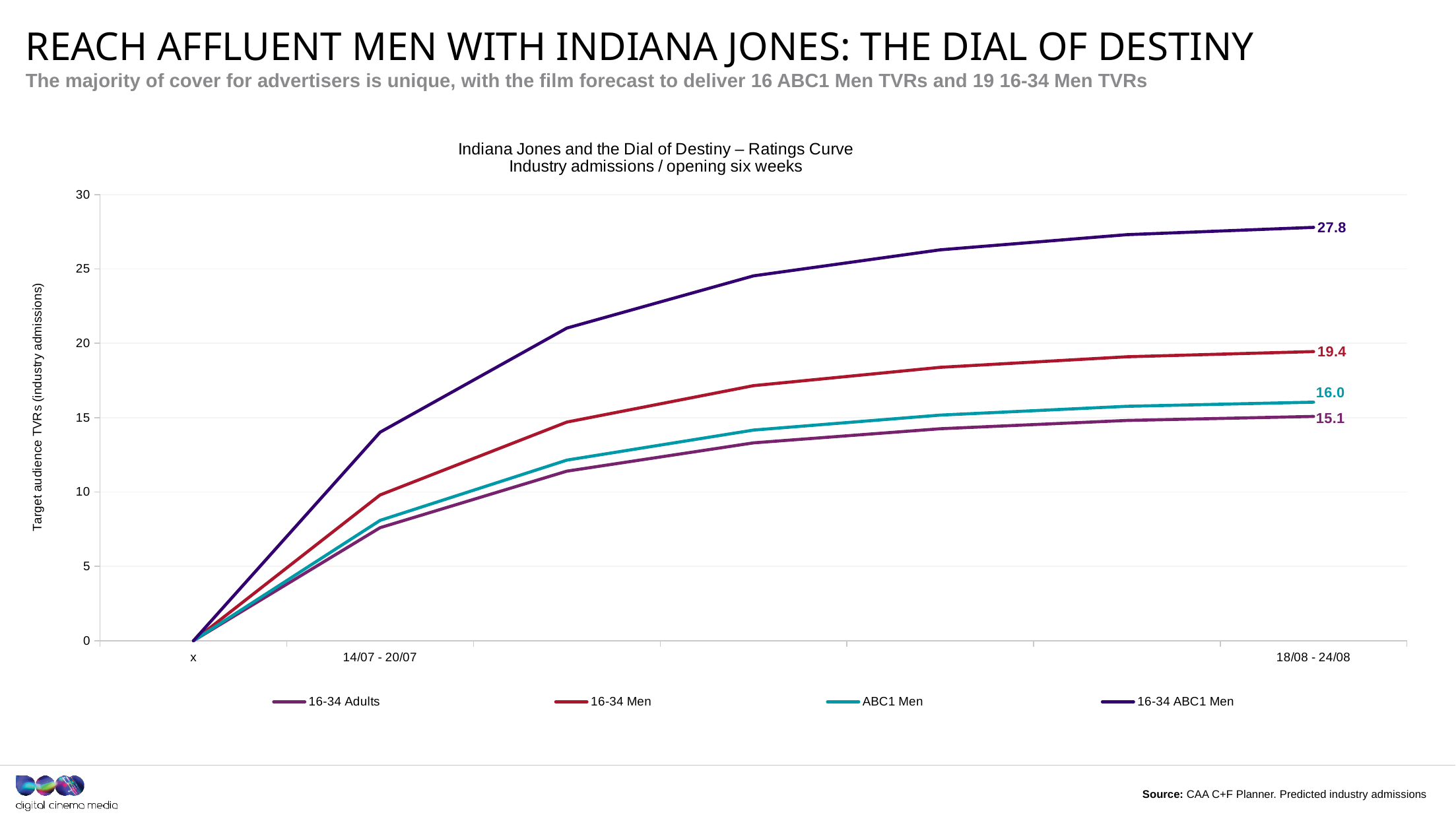
Which series has the lowest value at 18/08 - 24/08? 16-34 Adults Which series has the larger final value, ABC1 Men or 16-34 Men? 16-34 Men How many series does the legend list? 4 What is the final value for the ABC1 Men series at 18/08 - 24/08? 16.0 What is the final value for the 16-34 Men series at 18/08 - 24/08? 19.4 What type of chart is shown on the slide? line chart Do the values for each series rise or fall along the x axis? rise What is the difference between the final values of 16-34 ABC1 Men and 16-34 Men? 8.4 Which series reaches the highest value at 18/08 - 24/08? 16-34 ABC1 Men What is the final value for the 16-34 ABC1 Men series at 18/08 - 24/08? 27.8 What is the final value for the 16-34 Adults series at 18/08 - 24/08? 15.1 Is the value for 16-34 ABC1 Men at 14/07 - 20/07 greater or less than 10? greater